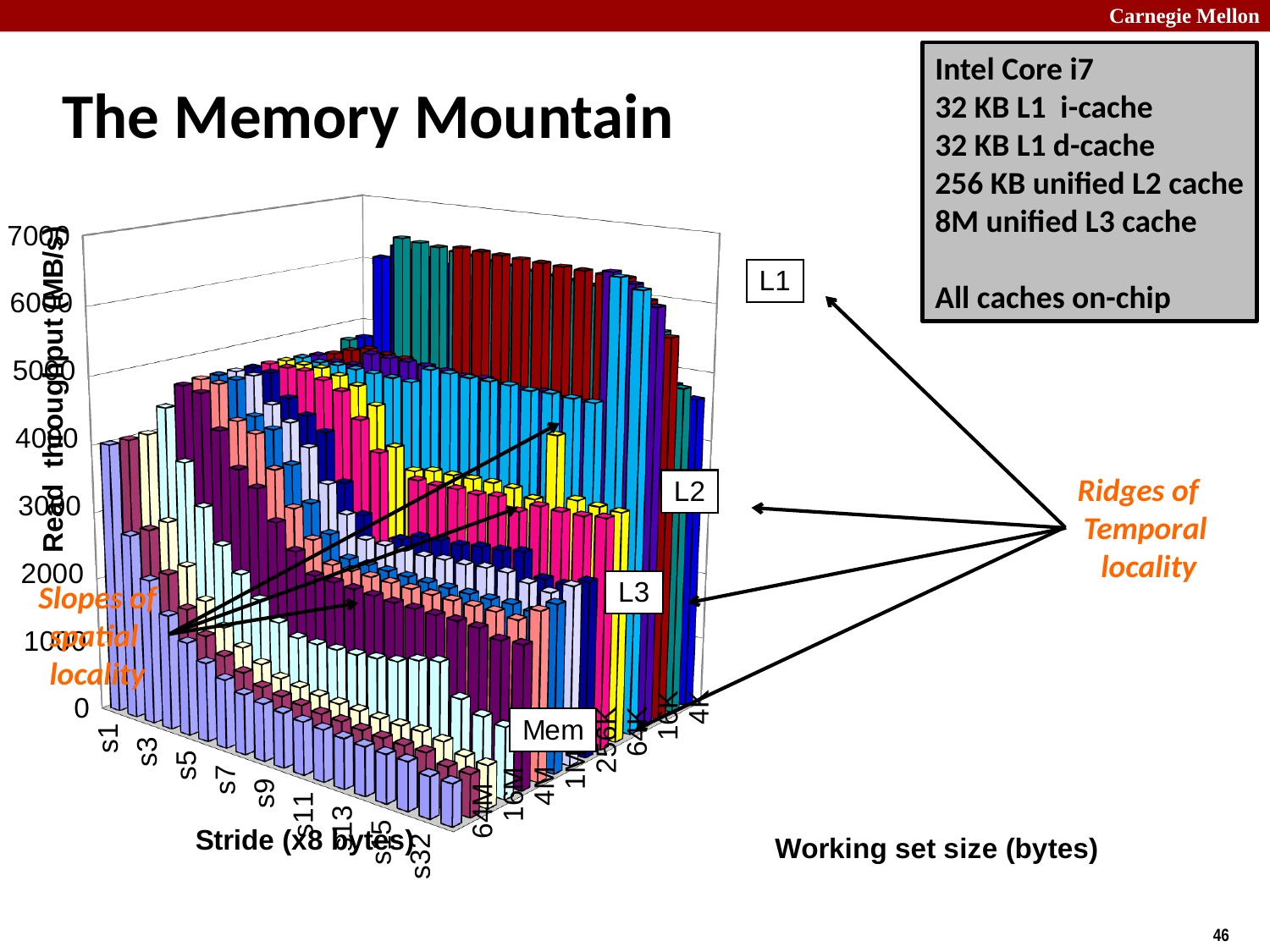
Which working set size has the higher read throughput at stride s1: 4K or 64M? 4K What is the highest tick value shown on the vertical axis? 7000 What kind of chart is shown on the slide? 3D bar chart How many working set size labels are shown along the working set size axis? 8 What is the label of the vertical axis of the chart? Read throughput (MB/s) Is the read throughput for stride s32 at the 64M working set greater or less than 2000? less What is the title of the chart on the slide? The Memory Mountain For the 64M working set, does read throughput rise or fall as the stride increases from s1 to s32? fall How many stride labels are shown along the stride axis? 9 For stride s1, does read throughput rise or fall as the working set size decreases from 64M to 4K? rise Which stride has the lower read throughput at the 64M working set: s1 or s32? s32